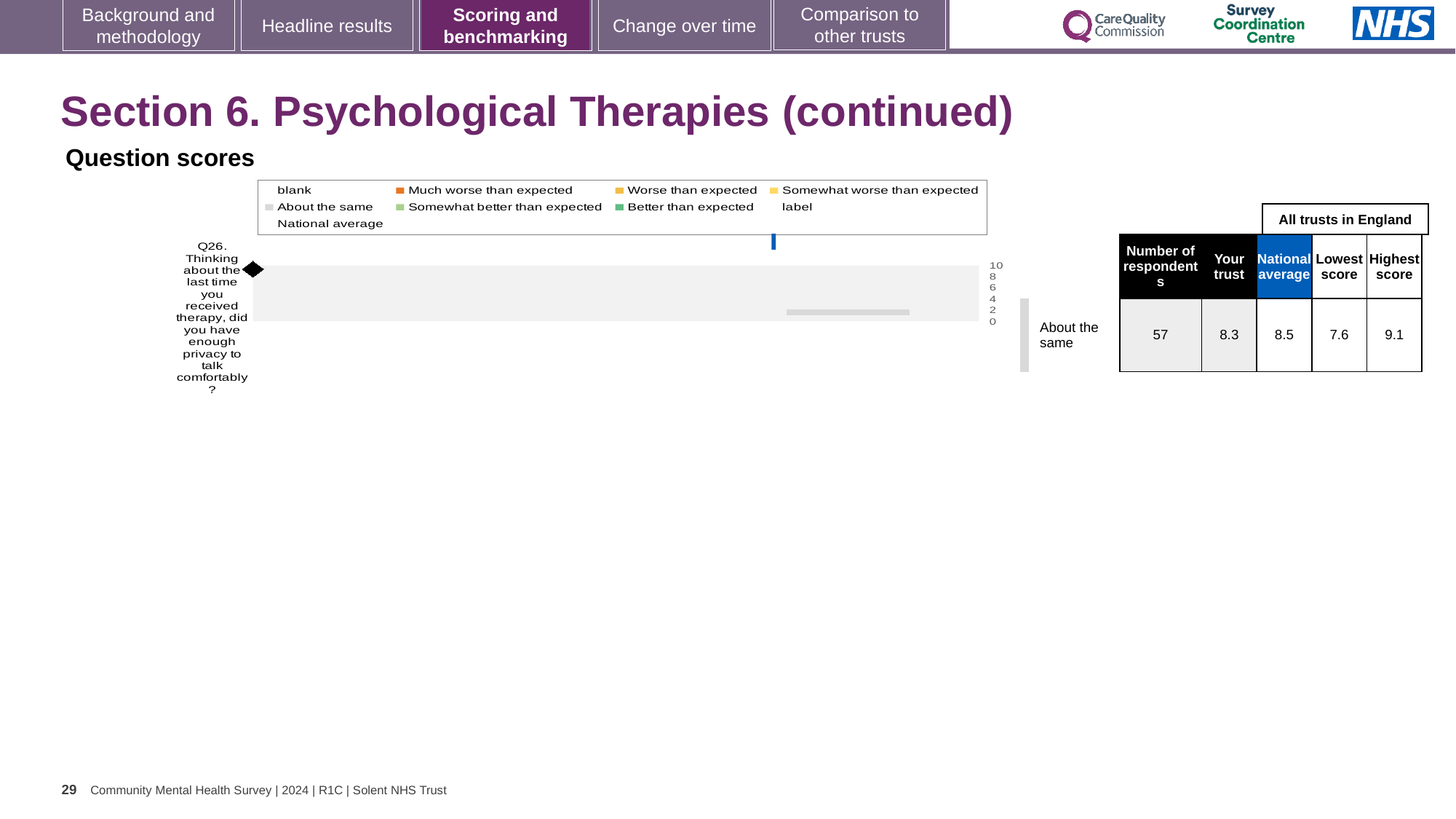
What heading appears above the Lowest score and Highest score columns in the table? All trusts in England For Q26, which is higher: the 'Your trust' score or the national average? National average What kind of chart is used to show the Q26 question score? bar chart How many respondents answered Q26? 57 What is the highest score among all trusts in England for Q26? 9.1 Which benchmarking category is the Q26 bar assigned to? About the same What is the 'Your trust' score for Q26 about having enough privacy to talk comfortably? 8.3 What is the national average score for Q26? 8.5 What is the lowest score among all trusts in England for Q26? 7.6 What is the difference between the highest and lowest trust scores for Q26? 1.5 By how much does the national average exceed the 'Your trust' score for Q26? 0.2 How many survey questions are plotted in the question scores chart? 1